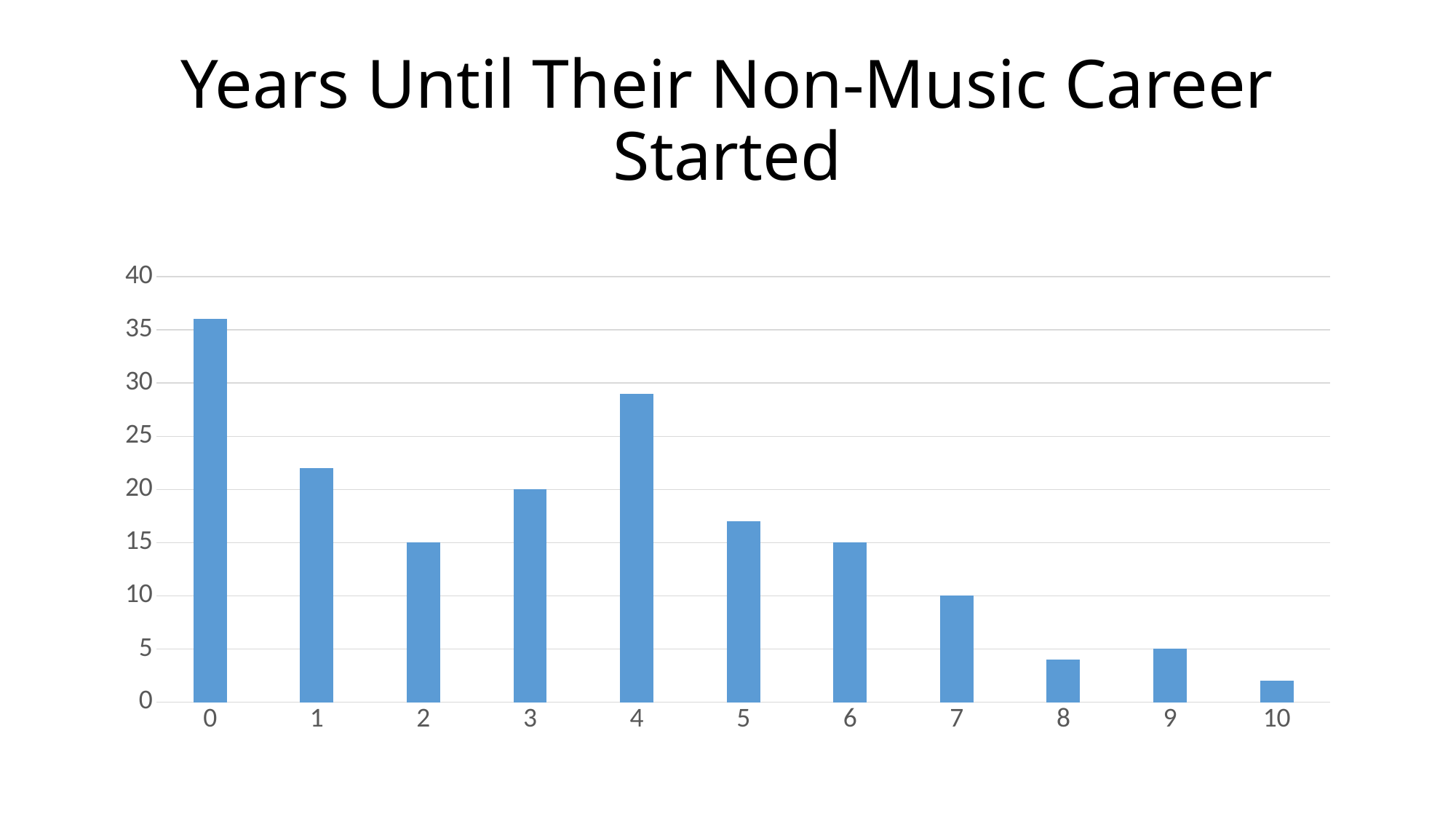
Is the value for category 0 greater or less than 35? greater Is the value for category 4 greater or less than 30? less Which category has the highest bar? 0 What is the title of the chart? Years Until Their Non-Music Career Started What is the value for category 7? 10 What is the value for category 9? 5 What is the difference between the values for category 3 and category 7? 10 How many categories are shown on the x axis? 11 What is the value for category 3? 20 Which category has the lowest bar? 10 What type of chart is shown on the slide? bar chart Which is larger, the value for category 1 or the value for category 5? 1